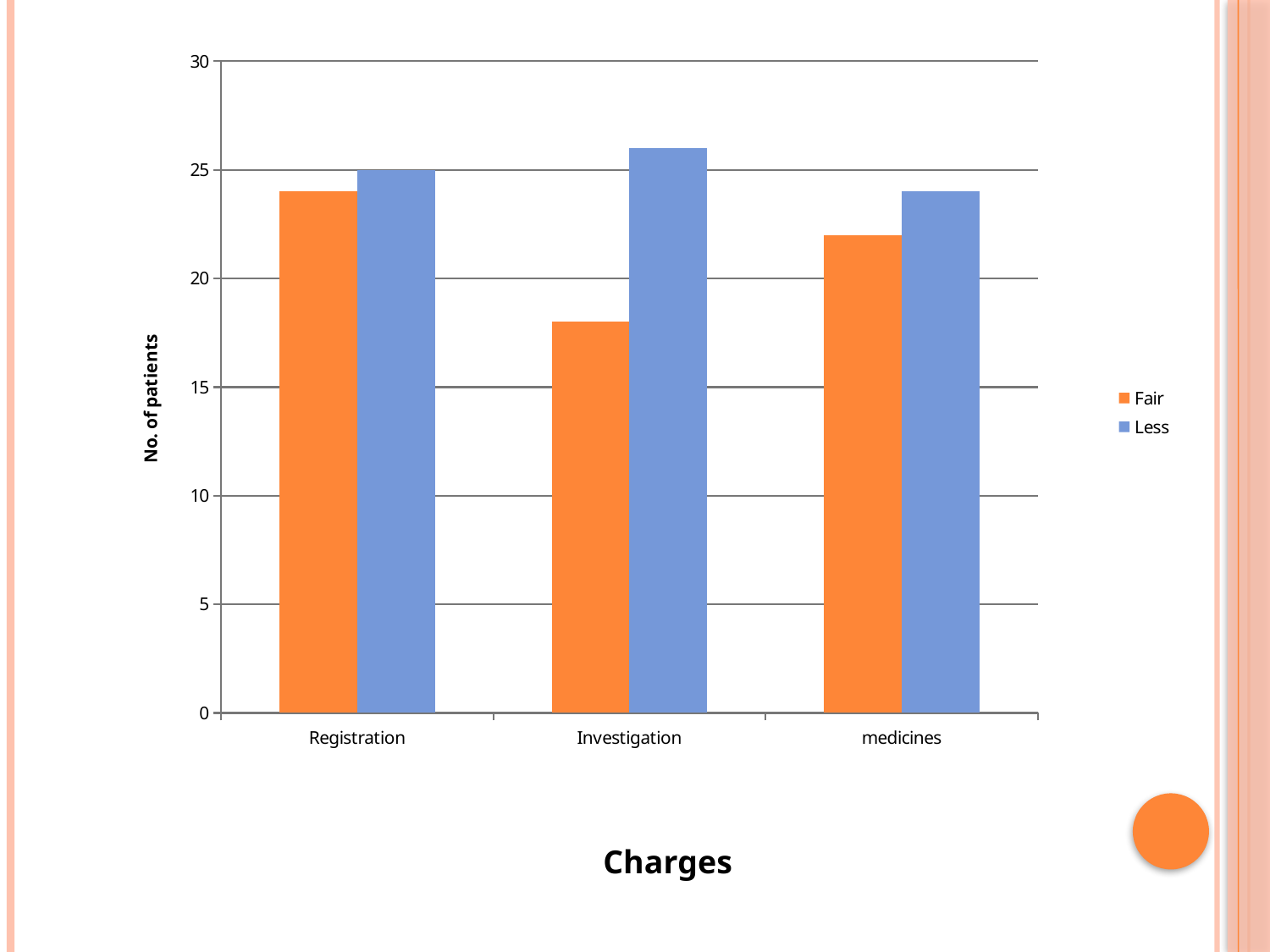
How many categories are shown on the x axis? 3 How many series does the legend list? 2 What is the label of the x axis? Charges Is the Fair value for medicines greater or less than 20? greater What kind of chart is shown on the slide? bar chart Which category has the lowest value for the Fair series? Investigation Is the Less value for Registration greater or less than 20? greater For Investigation, which is larger: Fair or Less? Less Is the Less value for Investigation greater or less than 20? greater What is the label of the y axis? No. of patients